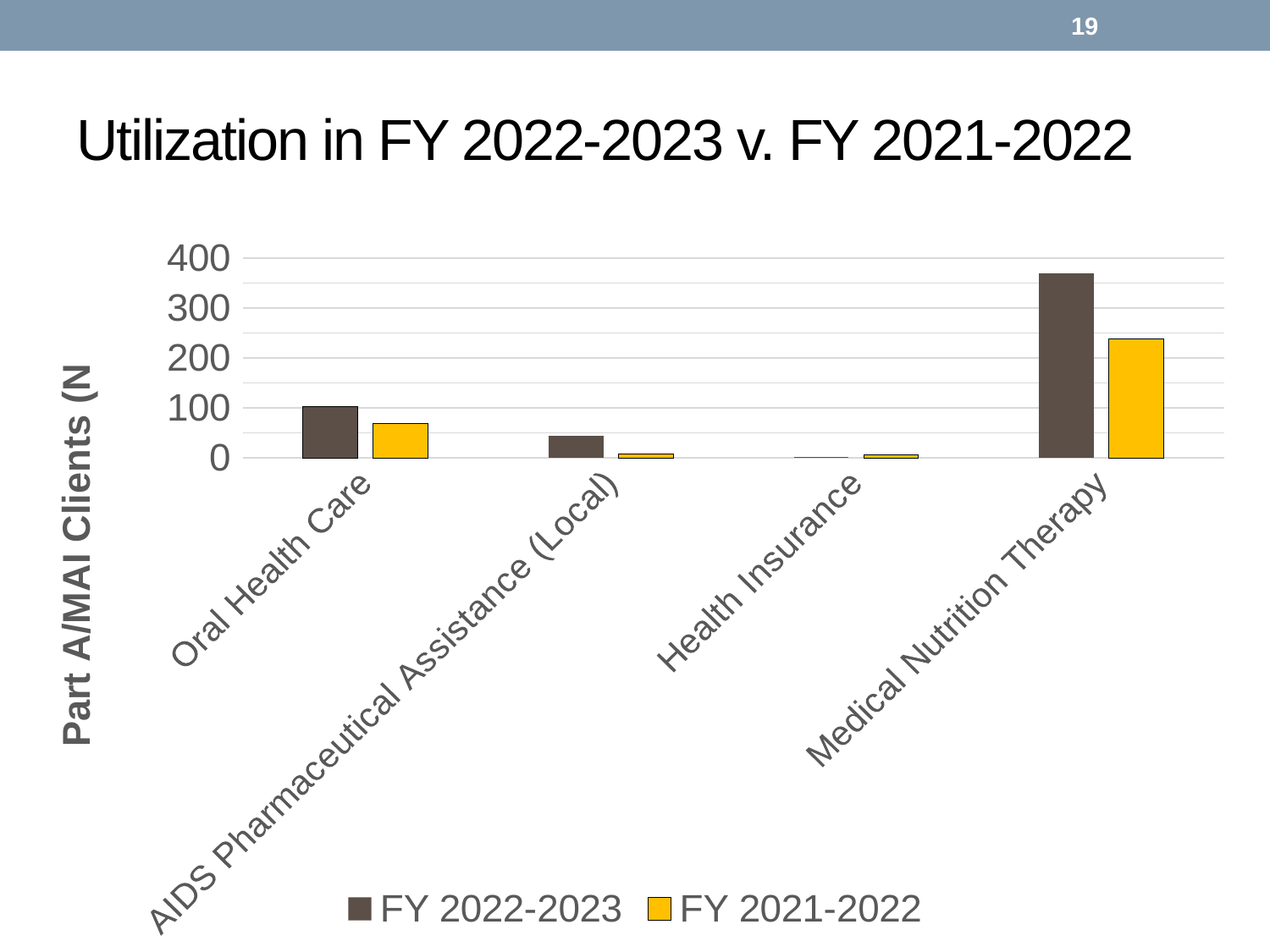
Which category has the highest FY 2021-2022 value? Medical Nutrition Therapy Which category has the lowest FY 2022-2023 value? Health Insurance For Oral Health Care, which series is larger: FY 2022-2023 or FY 2021-2022? FY 2022-2023 How many service categories are shown on the x axis? 4 Is the FY 2022-2023 value for Medical Nutrition Therapy greater or less than 300? greater For Medical Nutrition Therapy, which series is larger: FY 2022-2023 or FY 2021-2022? FY 2022-2023 Is the FY 2022-2023 value for AIDS Pharmaceutical Assistance (Local) greater or less than 100? less What kind of chart is shown on the slide? bar chart Which category has the highest FY 2022-2023 value? Medical Nutrition Therapy What is the label on the vertical axis of the chart? Part A/MAI Clients (N Is the FY 2021-2022 value for Medical Nutrition Therapy greater or less than 300? less How many series does the legend list? 2